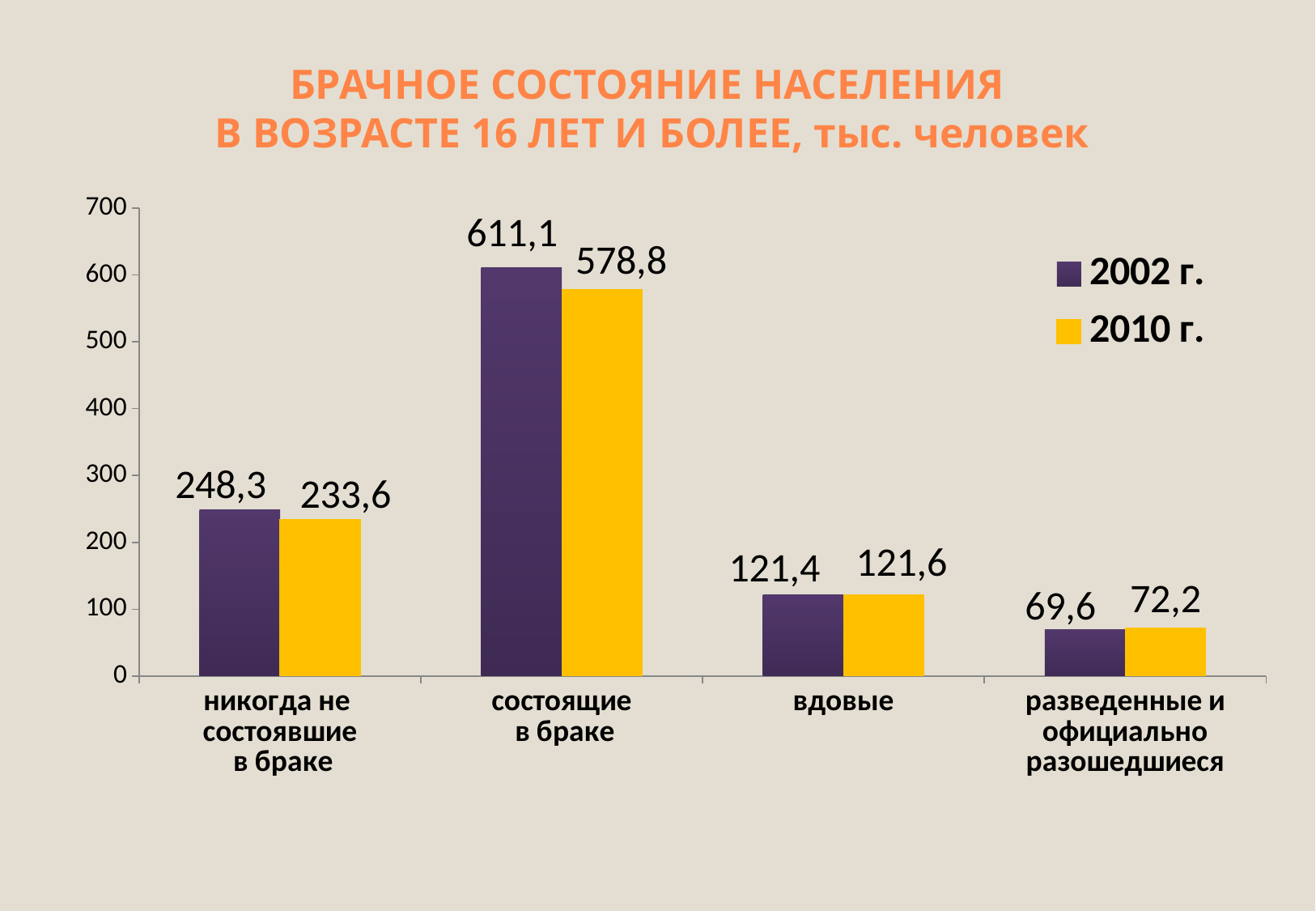
What is the value for «никогда не состоявшие в браке» in 2010 г.? 233,6 How many series does the legend list? 2 What is the value for «разведенные и официально разошедшиеся» in 2002 г.? 69,6 What is the difference between the 2002 г. and 2010 г. values for «состоящие в браке»? 32,3 Which is larger for «разведенные и официально разошедшиеся»: the 2002 г. value or the 2010 г. value? 2010 г. Which category has the lowest value in the 2010 г. series? разведенные и официально разошедшиеся What is the value for «состоящие в браке» in the 2002 г. series? 611,1 How many categories are shown on the x axis? 4 Which category has the highest value in the 2002 г. series? состоящие в браке What kind of chart is shown on the slide? bar chart What is the difference between the 2002 г. and 2010 г. values for «никогда не состоявшие в браке»? 14,7 What is the value for «состоящие в браке» in the 2010 г. series? 578,8